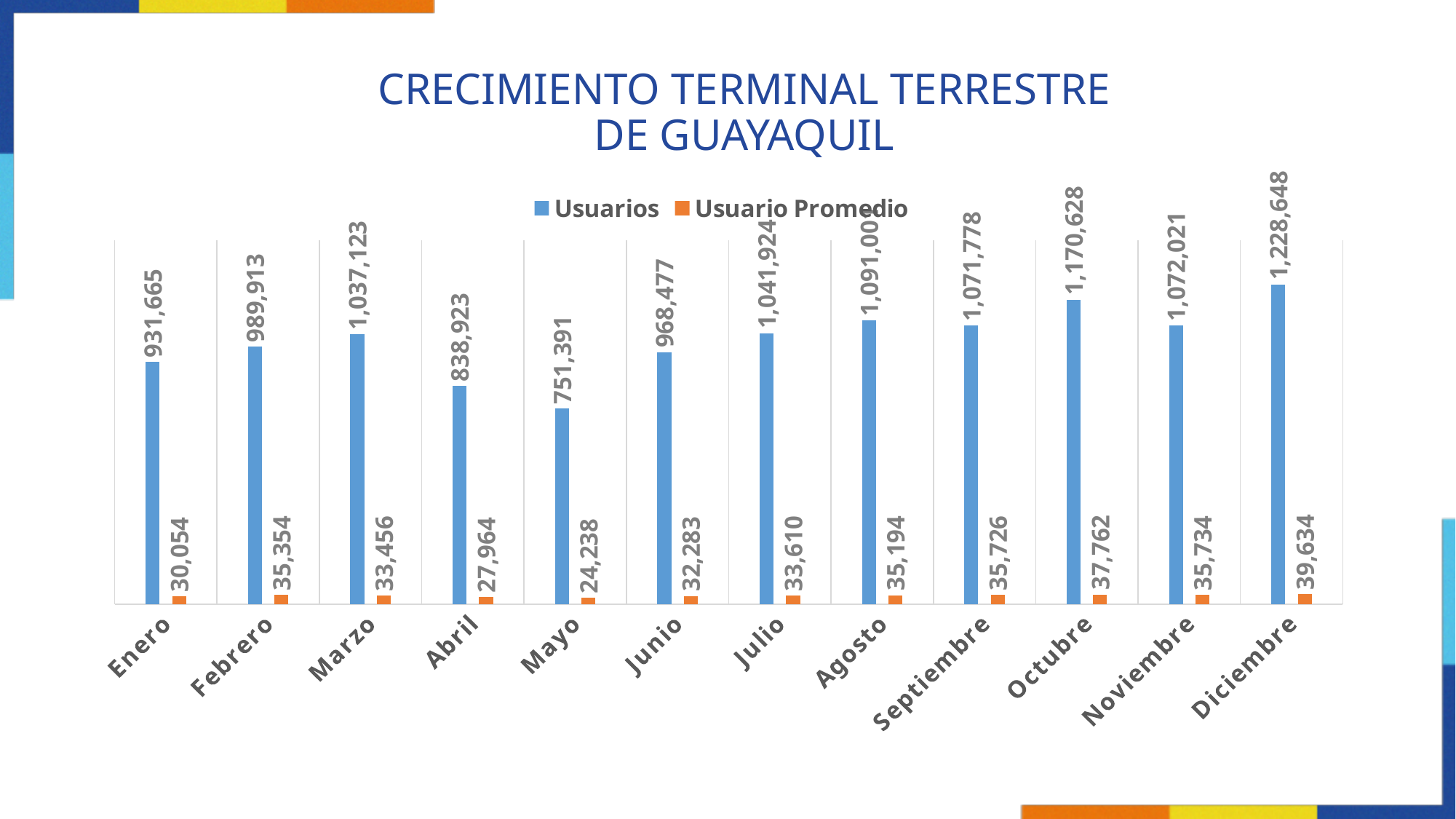
What is the Usuario Promedio value for Mayo? 24,238 Which month has the highest Usuarios value? Diciembre What is the difference between the Usuario Promedio values for Octubre and Enero? 7,708 Which month has the highest Usuario Promedio value? Diciembre How many series does the legend list? 2 What is the Usuarios value for Octubre? 1,170,628 What kind of chart is shown on the slide? Bar chart Which is larger, the Usuarios value for Marzo or for Febrero? Marzo What is the difference between the Usuarios values for Diciembre and Enero? 296,983 Which month has the lowest Usuarios value? Mayo What is the Usuarios value for Enero? 931,665 How many months are shown on the x axis? 12